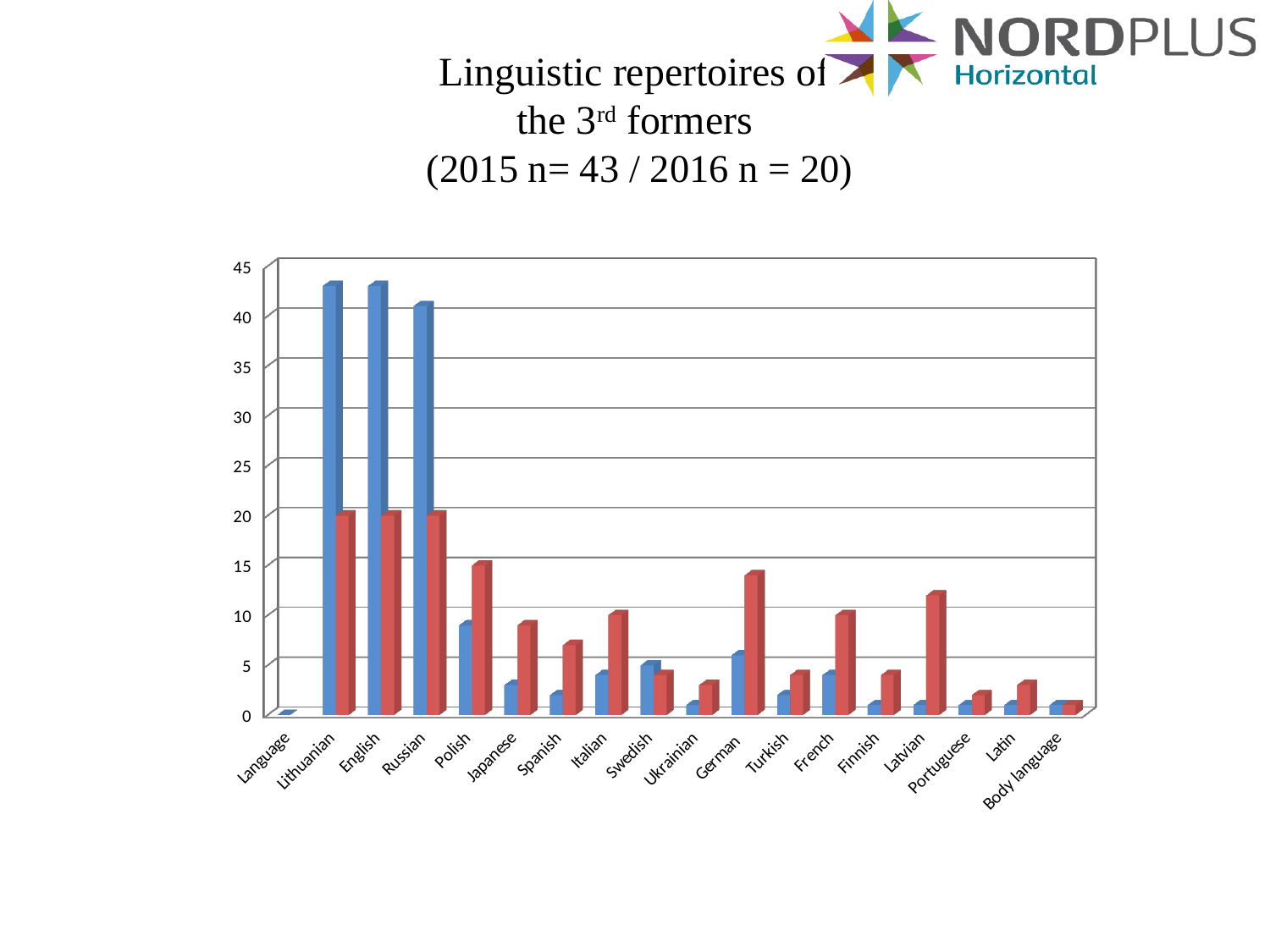
Is the blue bar for Swedish greater or less than 10? less Is the red bar for Polish greater or less than 10? greater What kind of chart is shown on the slide? bar chart Is the red bar for German greater or less than 10? greater For Lithuanian, which bar is taller, the blue one or the red one? the blue one What is the title of the slide containing the chart? Linguistic repertoires of the 3rd formers (2015 n= 43 / 2016 n = 20) How many categories are shown along the x axis of the chart? 18 Which is taller, the red bar for German or the red bar for Turkish? German For Polish, which bar is taller, the blue one or the red one? the red one